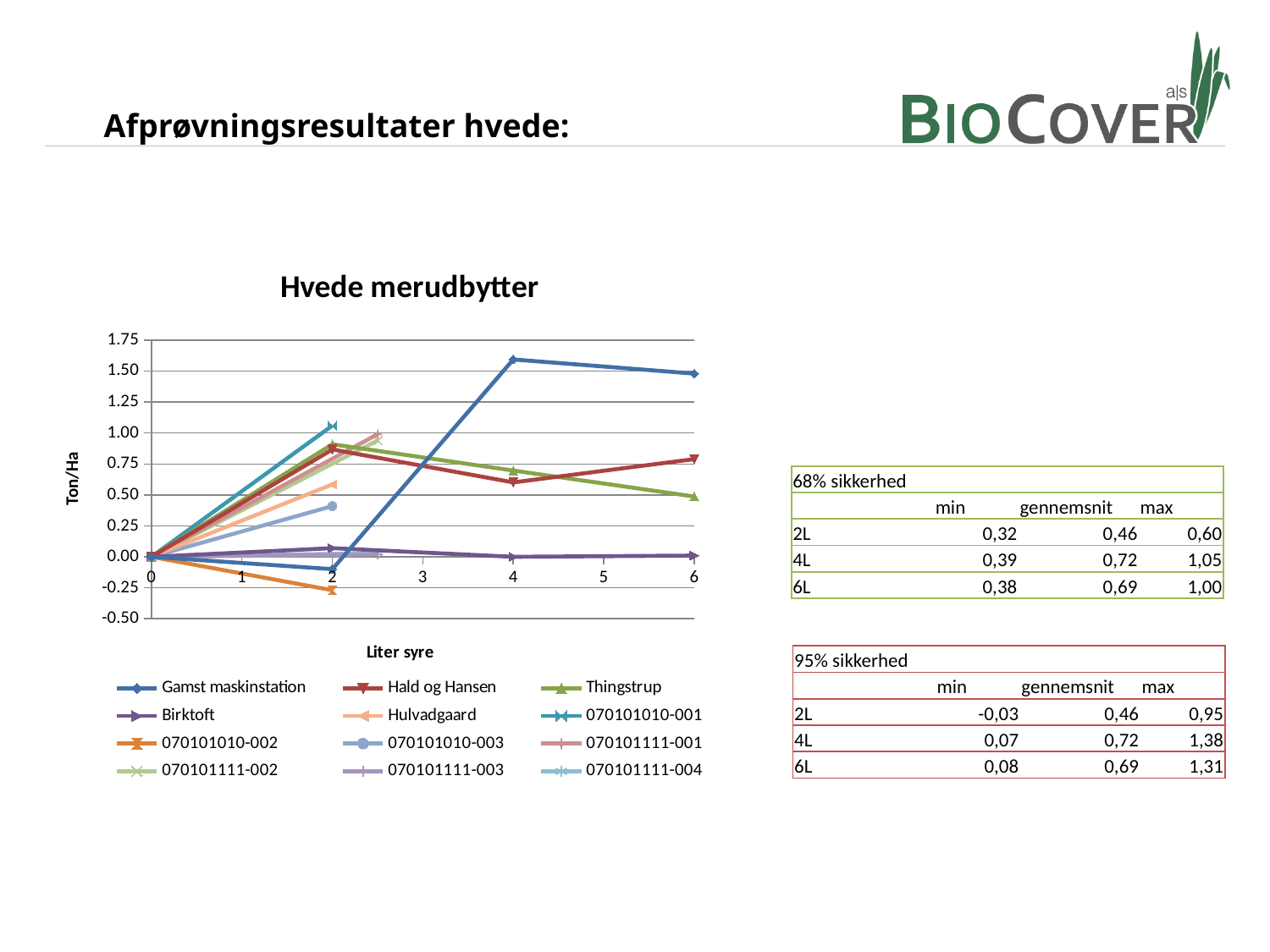
Is the value for 070101010-001 at 2 liter syre greater or less than 0.75? greater What is the label on the chart's vertical axis? Ton/Ha Does the Thingstrup line rise or fall between 2 and 6 liter syre? fall Is the value for Birktoft at 6 liter syre greater or less than 0.50? less What is the title of the chart? Hvede merudbytter Is the value for 070101010-002 at 2 liter syre greater or less than 0.00? less How many series does the chart's legend list? 12 Which series reaches the lowest value on the chart? 070101010-002 What kind of chart is shown on the slide? line chart Which series reaches the highest value on the chart? Gamst maskinstation At 6 liter syre, which is higher: Hald og Hansen or Thingstrup? Hald og Hansen